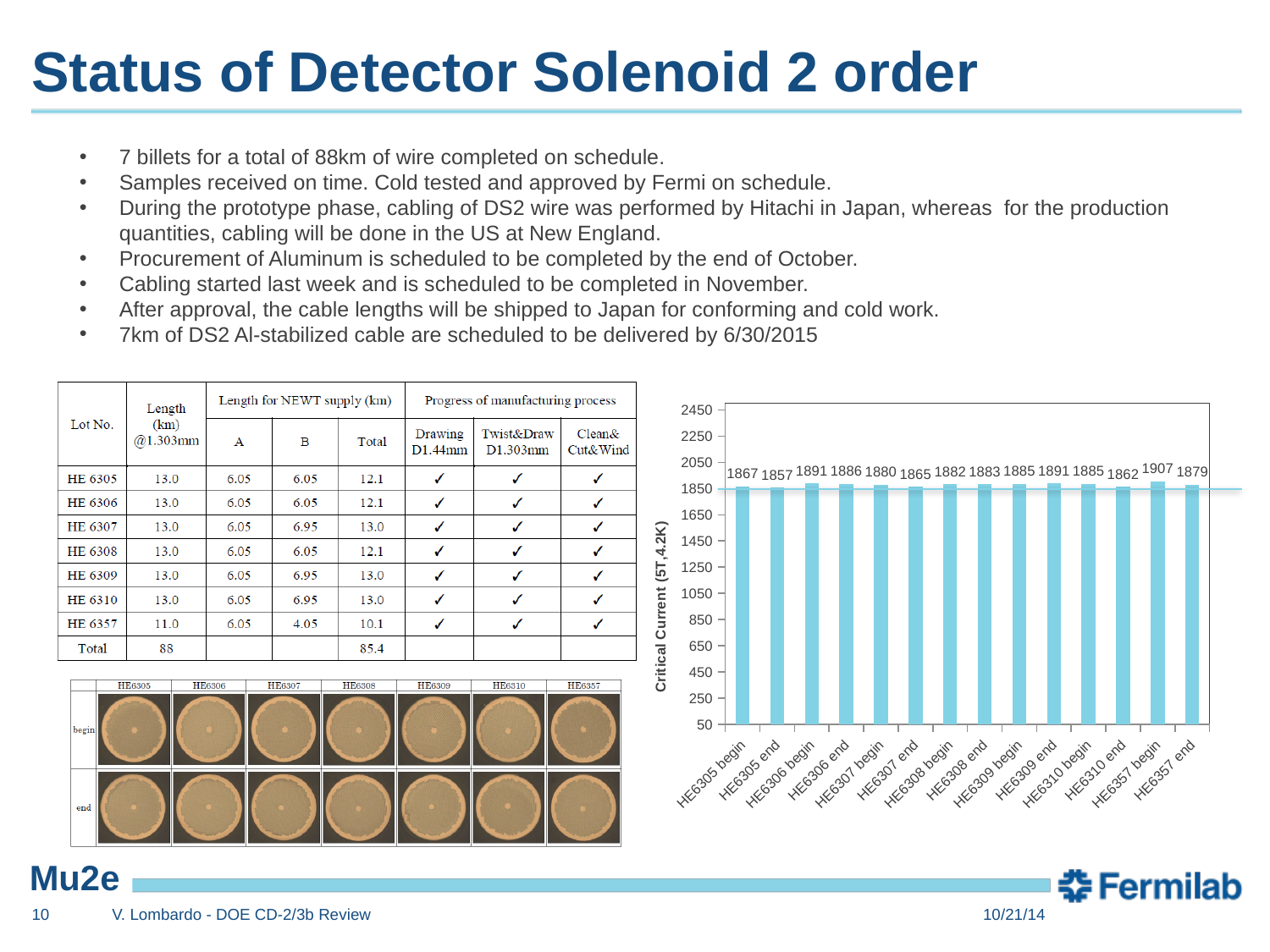
What is the difference between the critical current values for HE6357 begin and HE6357 end? 28 Which has a larger critical current value, HE6306 begin or HE6305 begin? HE6306 begin What is the label on the vertical axis of the chart? Critical Current (5T, 4.2K) How many bars are plotted in the critical current chart? 14 What is the critical current value for HE6305 begin? 1867 What kind of chart is shown on the right side of the slide? bar chart What is the critical current value for HE6357 end? 1879 Is the critical current value for HE6307 begin greater or less than 1650? greater Which category has the highest critical current value? HE6357 begin Which category has the lowest critical current value? HE6305 end What is the difference between the critical current values for HE6305 begin and HE6305 end? 10 What is the critical current value for HE6309 end? 1891